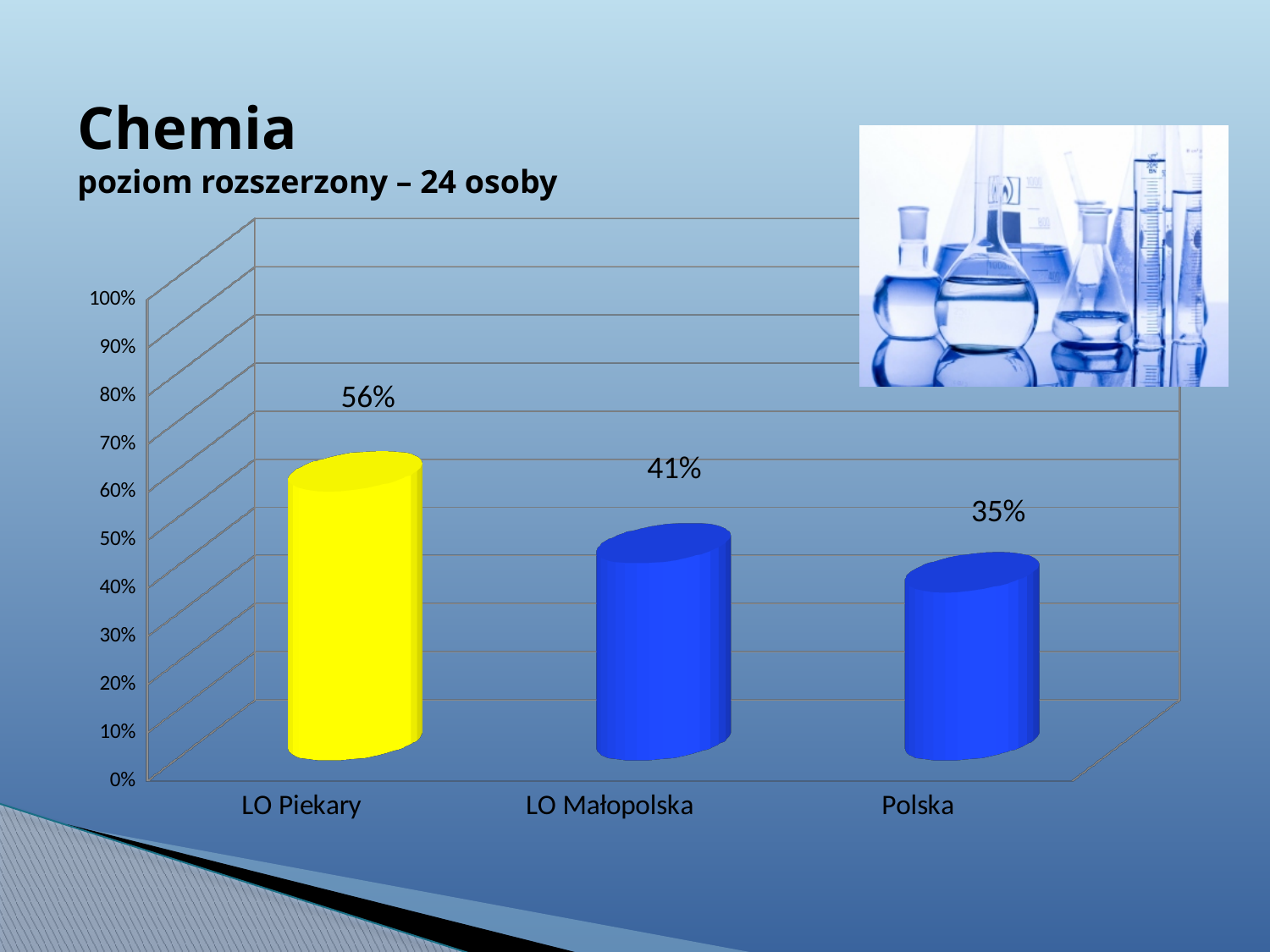
Which category has the lowest value? Polska Which bar is coloured yellow? LO Piekary What is the value for LO Piekary? 56% How many categories are shown in the chart? 3 What is the difference between the values for LO Piekary and Polska? 21% What is the difference between the values for LO Piekary and LO Małopolska? 15% What kind of chart is shown on the slide? bar chart What is the value for LO Małopolska? 41% Which category has the highest value? LO Piekary Which is larger, the value for LO Małopolska or the value for Polska? LO Małopolska What is the value for Polska? 35% Is the value for LO Piekary greater or less than 50%? greater